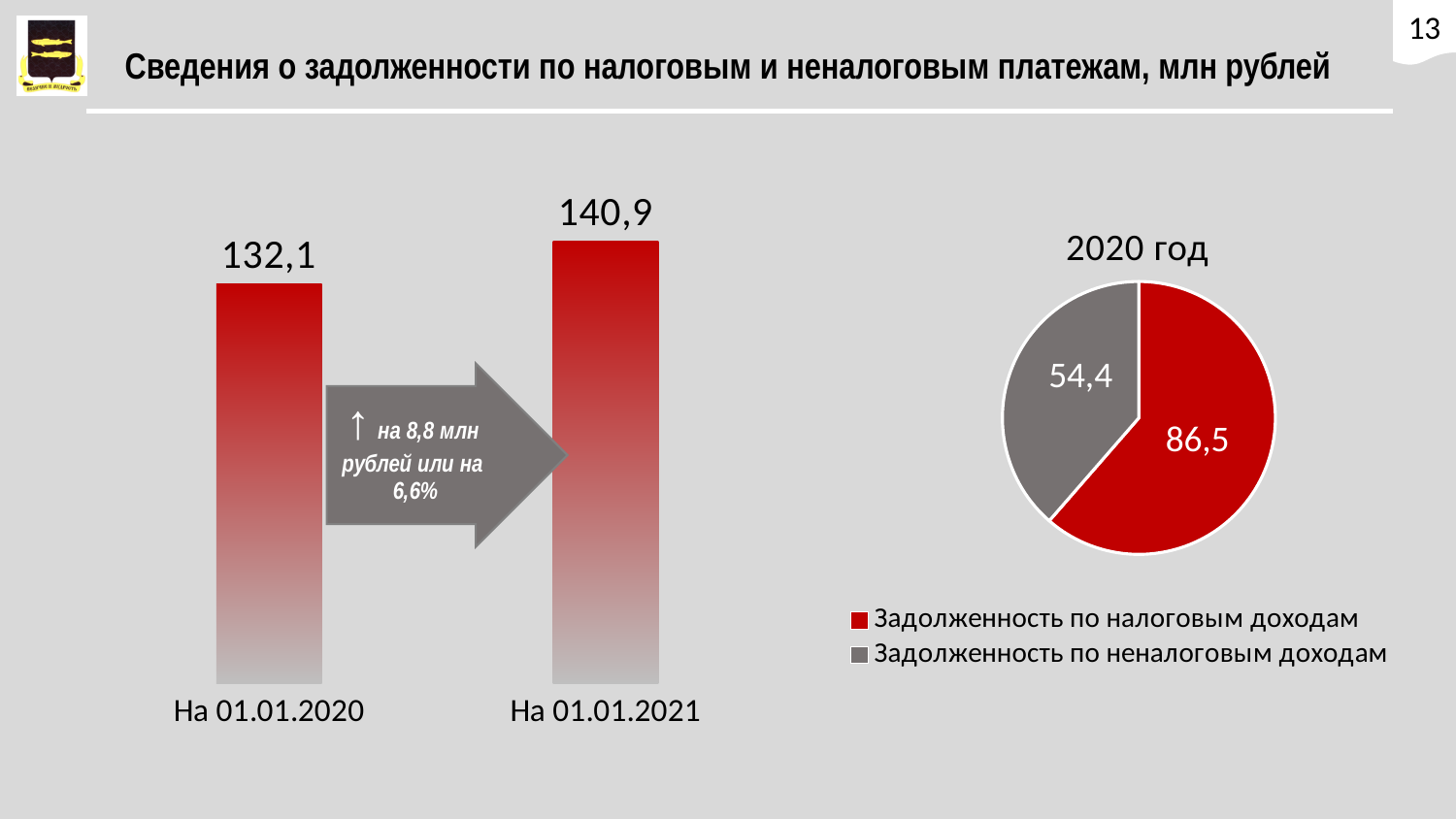
In the pie chart titled 2020 год, which slice is larger: Задолженность по налоговым доходам or Задолженность по неналоговым доходам? Задолженность по налоговым доходам In the bar chart on the left, how many bars are shown? 2 In the pie chart titled 2020 год, what is the value for Задолженность по неналоговым доходам? 54,4 In the bar chart on the left, do the values rise or fall from На 01.01.2020 to На 01.01.2021? rise What kind of chart is the chart on the left of the slide? bar chart In the bar chart on the left, what is the difference between the values for На 01.01.2021 and На 01.01.2020? 8,8 In the bar chart on the left, what is the value for На 01.01.2020? 132,1 In the bar chart on the left, what is the value for На 01.01.2021? 140,9 In the bar chart on the left, which date has the lower value? На 01.01.2020 How many entries does the legend of the pie chart titled 2020 год list? 2 In the pie chart titled 2020 год, what is the value for Задолженность по налоговым доходам? 86,5 In the bar chart on the left, which date has the higher value? На 01.01.2021